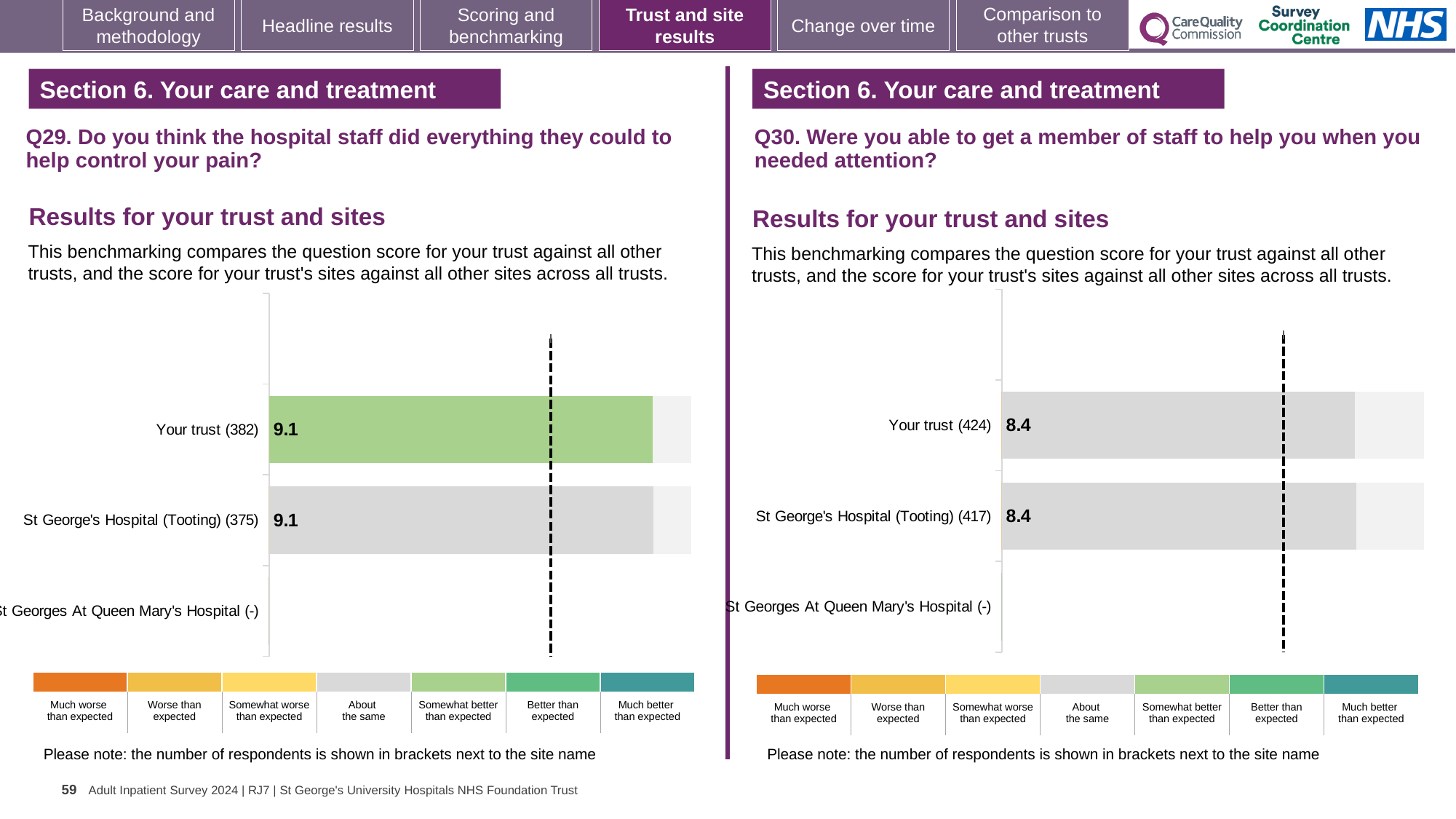
In the Q29 chart on the left, what is the difference between the scores for Your trust and St George's Hospital (Tooting)? 0 In the Q29 chart on the left, what is the score for Your trust (382)? 9.1 In the Q29 chart on the left, how many respondents are shown in brackets for Your trust? 382 What kind of chart is the Q29 chart on the left? Bar chart How many site/trust categories are listed on the y axis of the Q30 chart on the right? 3 In the Q29 chart on the left, what is the score for St George's Hospital (Tooting) (375)? 9.1 In the Q30 chart on the right, what is the score for St George's Hospital (Tooting) (417)? 8.4 In the Q29 chart on the left, which benchmark category does the green colour of the Your trust bar correspond to in the key? Somewhat better than expected In the Q30 chart on the right, what is the score for Your trust (424)? 8.4 Which is larger: the Your trust score in the Q29 chart on the left or the Your trust score in the Q30 chart on the right? Q29 (9.1) How many benchmark categories does the colour key below the Q30 chart on the right list? 7 What is the difference between the Your trust score in the Q29 chart on the left and the Your trust score in the Q30 chart on the right? 0.7